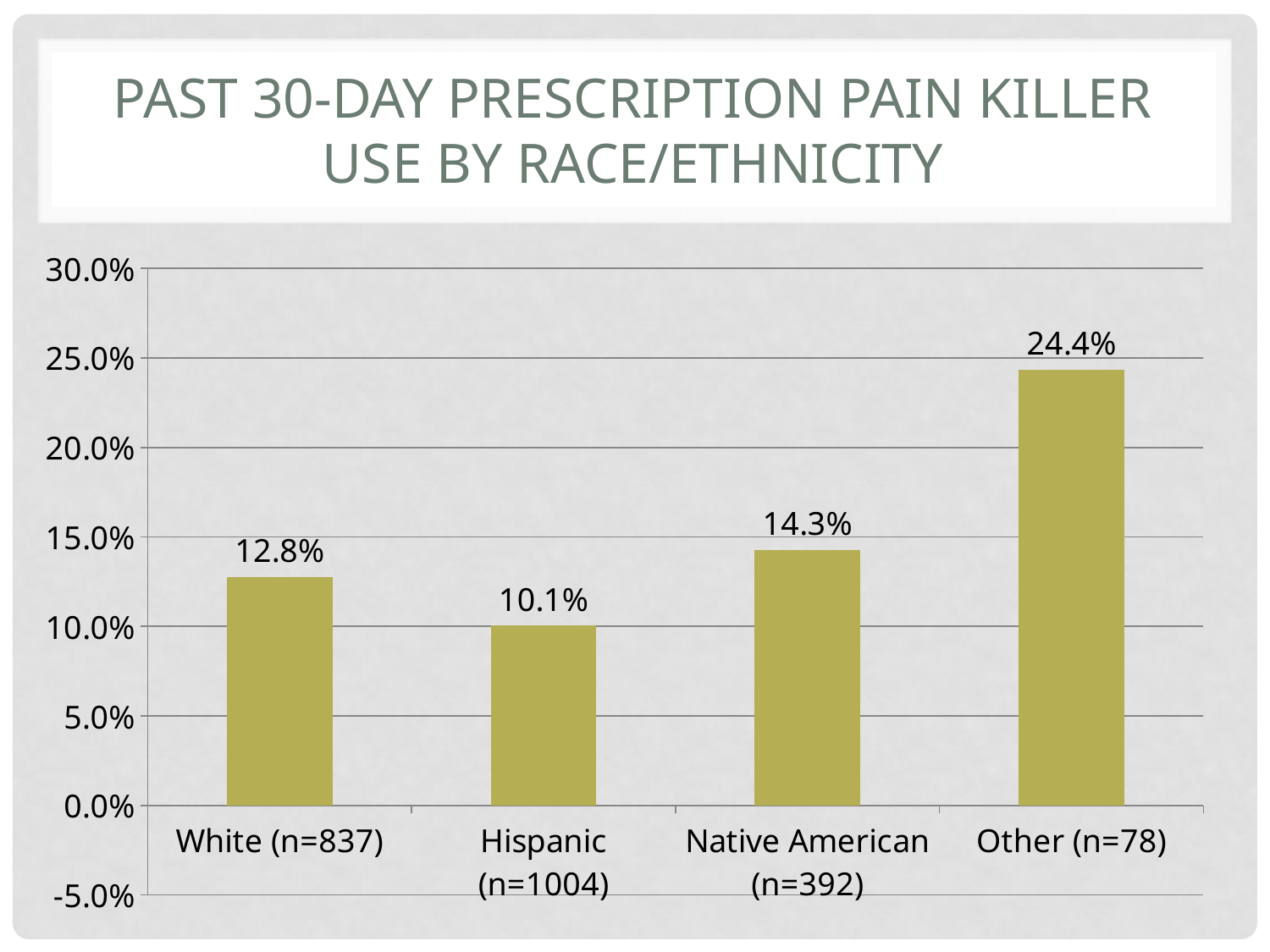
What is the past 30-day prescription pain killer use for White (n=837)? 12.8% Which race/ethnicity group has the lowest past 30-day prescription pain killer use? Hispanic (n=1004) What is the value shown for Native American (n=392)? 14.3% Which race/ethnicity group has the highest past 30-day prescription pain killer use? Other (n=78) What kind of chart is shown on the slide? Bar chart How many race/ethnicity categories are shown on the chart? 4 What is the difference in percentage points between Other (n=78) and Hispanic (n=1004)? 14.3% What is the value shown for Hispanic (n=1004)? 10.1% What is the value shown for Other (n=78)? 24.4% Which is larger, the value for White (n=837) or the value for Native American (n=392)? Native American (n=392) What is the difference in percentage points between Native American (n=392) and White (n=837)? 1.5% Is the value for Other (n=78) greater or less than 20.0%? greater